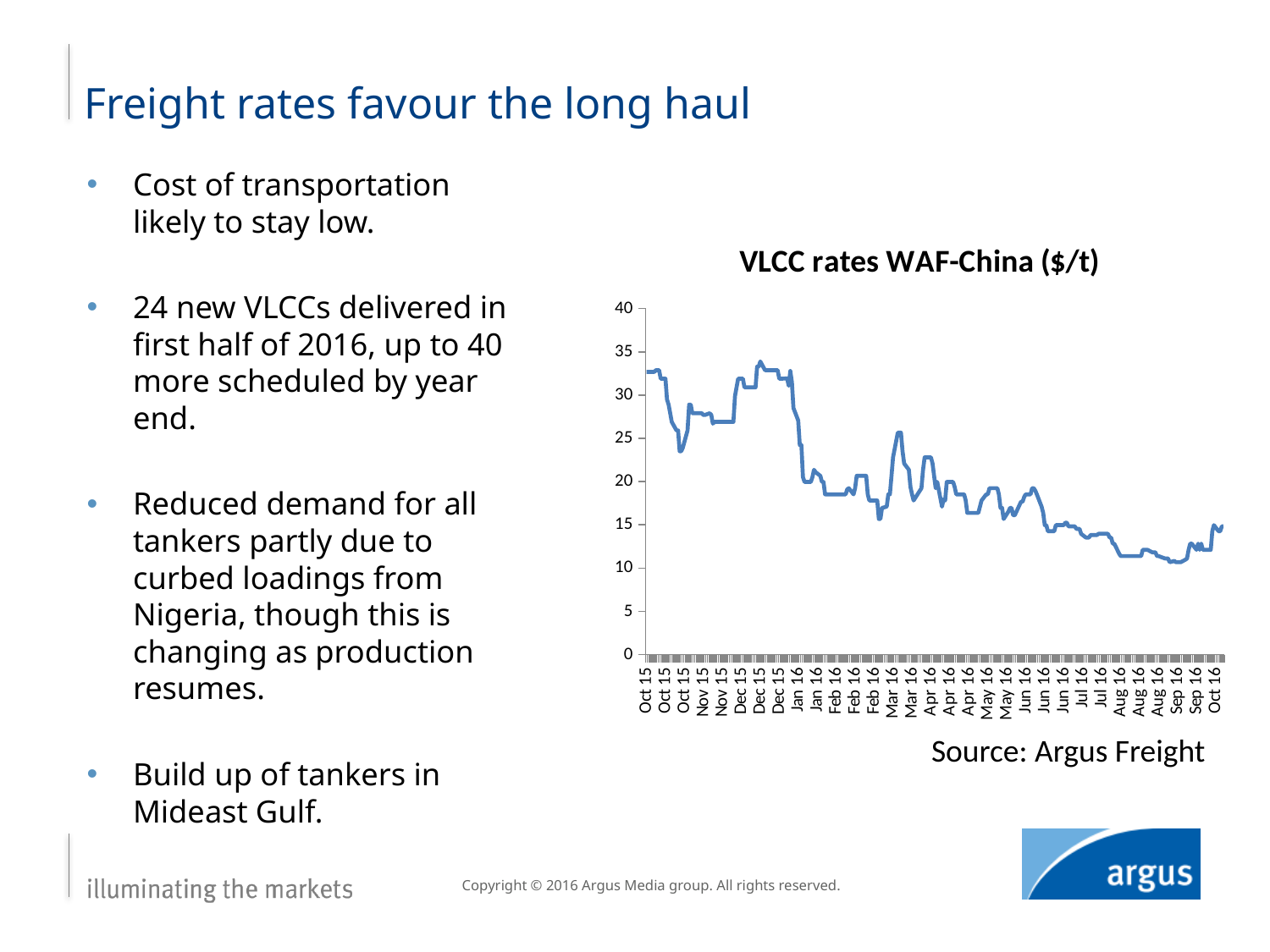
What kind of chart is shown on the slide? line chart Is the VLCC rate at the start of Oct 15 greater or less than 30? greater What is the source cited below the chart? Argus Freight What is the title of the chart? VLCC rates WAF-China ($/t) Which is higher, the VLCC rate in Dec 15 or in Jun 16? Dec 15 Is the VLCC rate in Aug 16 greater or less than 15? less Is the VLCC rate in Sep 16 greater or less than 15? less How many lines are plotted on the chart? 1 Overall, do VLCC rates rise or fall from Oct 15 to Oct 16? fall Which is higher, the VLCC rate in Oct 15 or in Oct 16? Oct 15